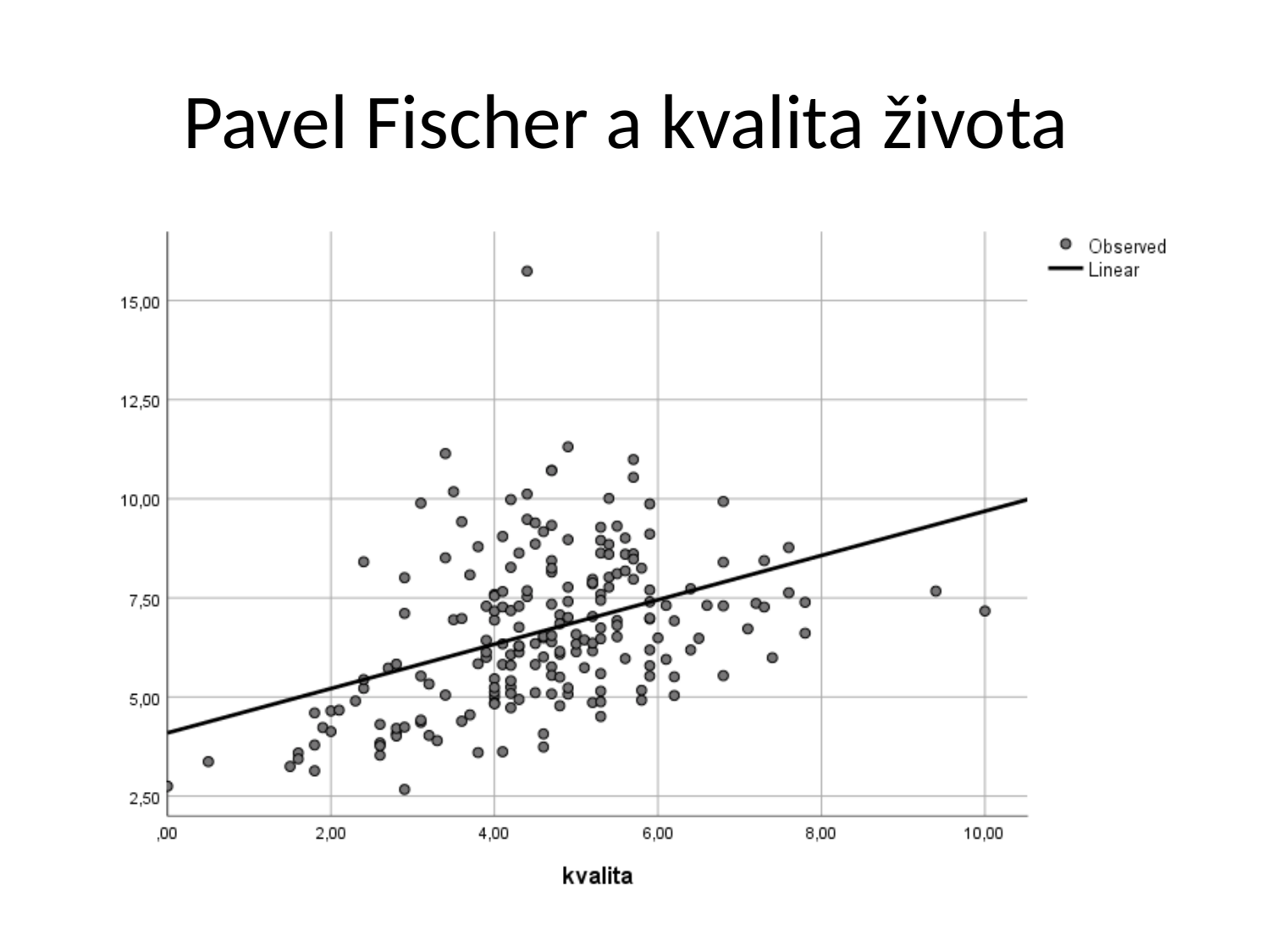
Is the highest observed point on the chart greater or less than 15,00 on the y axis? greater Does the Linear fit line rise or fall as kvalita increases along the x axis? rises What is the lowest tick value shown on the y axis? 2,50 What are the two entries in the chart legend? Observed and Linear How many entries does the chart legend list? 2 What kind of chart is shown on the slide? scatter plot Is the value of the Linear line at kvalita = ,00 greater or less than 5,00? less Is the value of the Linear line at kvalita = 8,00 greater or less than 7,50? greater What is the label of the x axis? kvalita What is the highest tick value shown on the x axis? 10,00